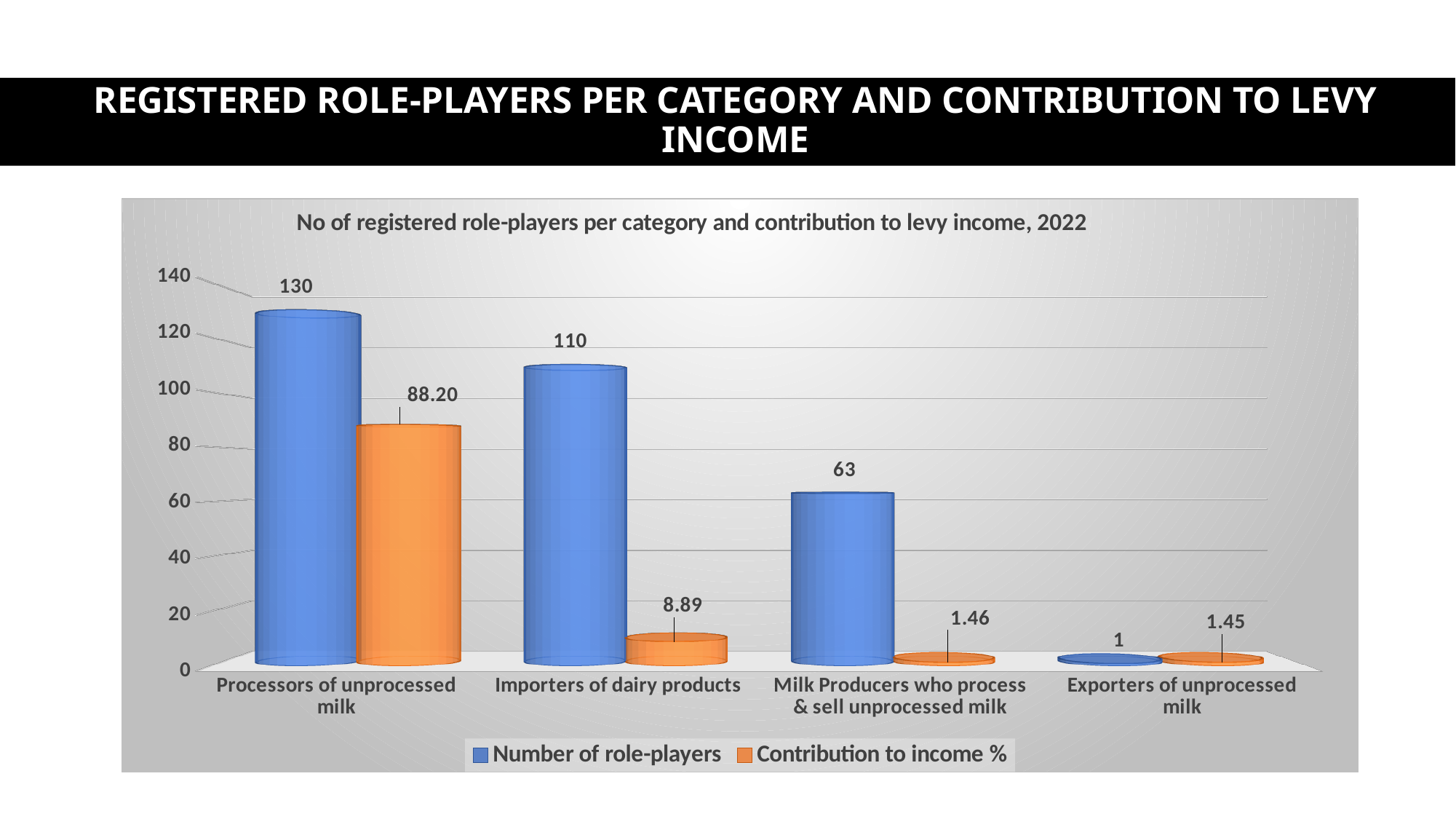
What is the difference in number of role-players between Processors of unprocessed milk and Importers of dairy products? 20 What is the number of role-players for Exporters of unprocessed milk? 1 Which is larger: the number of role-players for Importers of dairy products or for Milk Producers who process & sell unprocessed milk? Importers of dairy products Which category has the lowest contribution to income %? Exporters of unprocessed milk How many categories are shown on the x axis? 4 Which category has the highest number of role-players? Processors of unprocessed milk How many series does the legend list? 2 What is the number of role-players for Processors of unprocessed milk? 130 What is the contribution to income % for Processors of unprocessed milk? 88.20 What is the contribution to income % for Importers of dairy products? 8.89 What kind of chart is shown on the slide? Bar chart Does the number of role-players rise or fall from left to right across the categories? Fall